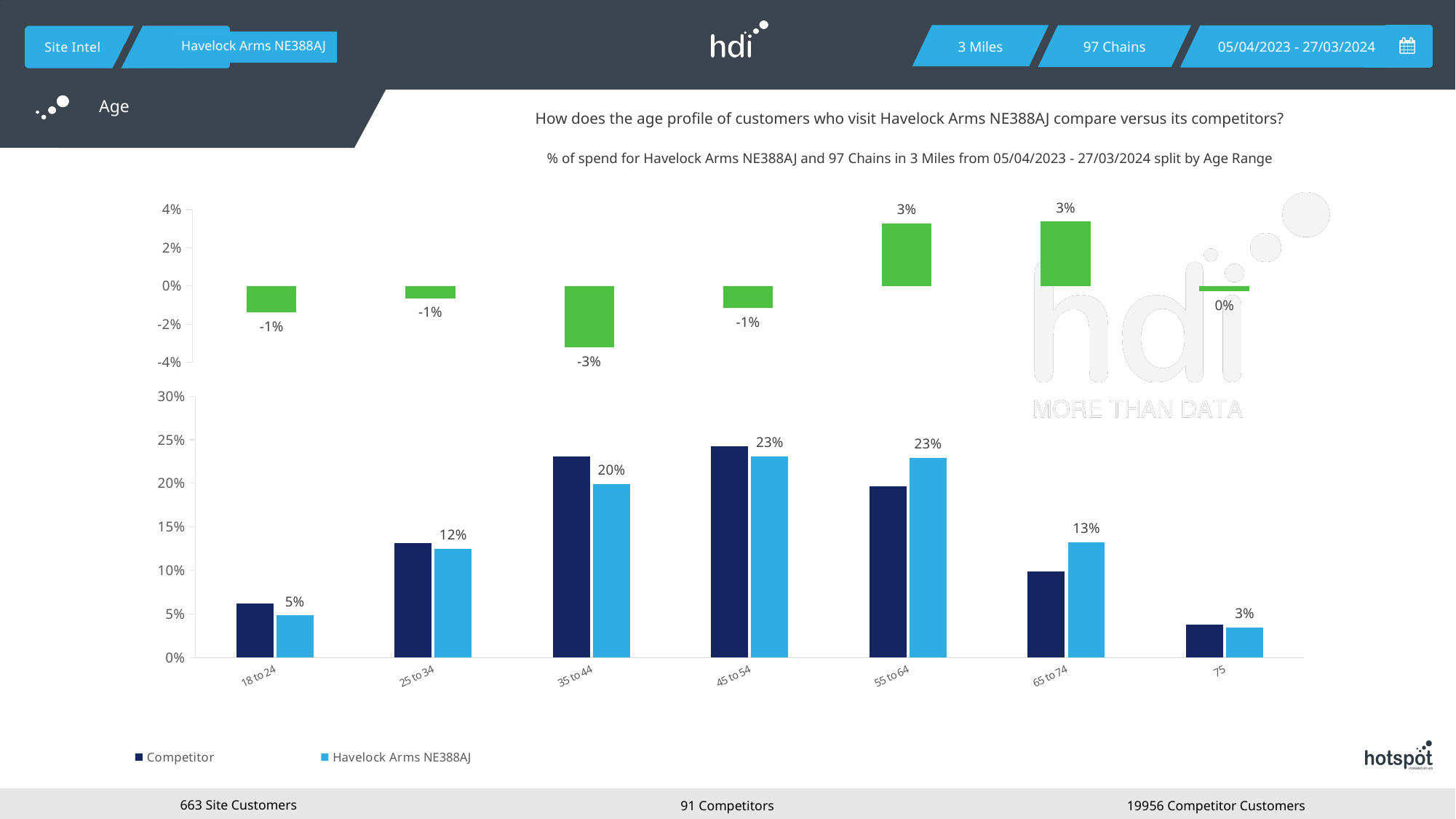
In the bottom chart, is the Competitor value for 45 to 54 greater or less than 20%? greater In the bottom chart, what is the difference between the Havelock Arms NE388AJ values for 45 to 54 and 18 to 24? 18% In the top chart, which age range has the lowest value? 35 to 44 In the top chart, what is the value shown for the 35 to 44 age range? -3% In the top chart, what is the value shown for the 55 to 64 age range? 3% In the bottom chart, for the 65 to 74 age range, which is larger: Competitor or Havelock Arms NE388AJ? Havelock Arms NE388AJ How many age range categories are shown on the x axis of the bottom chart? 7 In the bottom chart, what is the value for Havelock Arms NE388AJ in the 65 to 74 age range? 13% How many series does the legend of the bottom chart list? 2 In the bottom chart, which age range has the lowest value for Havelock Arms NE388AJ? 75 What kind of chart is the bottom chart? bar chart In the bottom chart, what is the value for Havelock Arms NE388AJ in the 35 to 44 age range? 20%